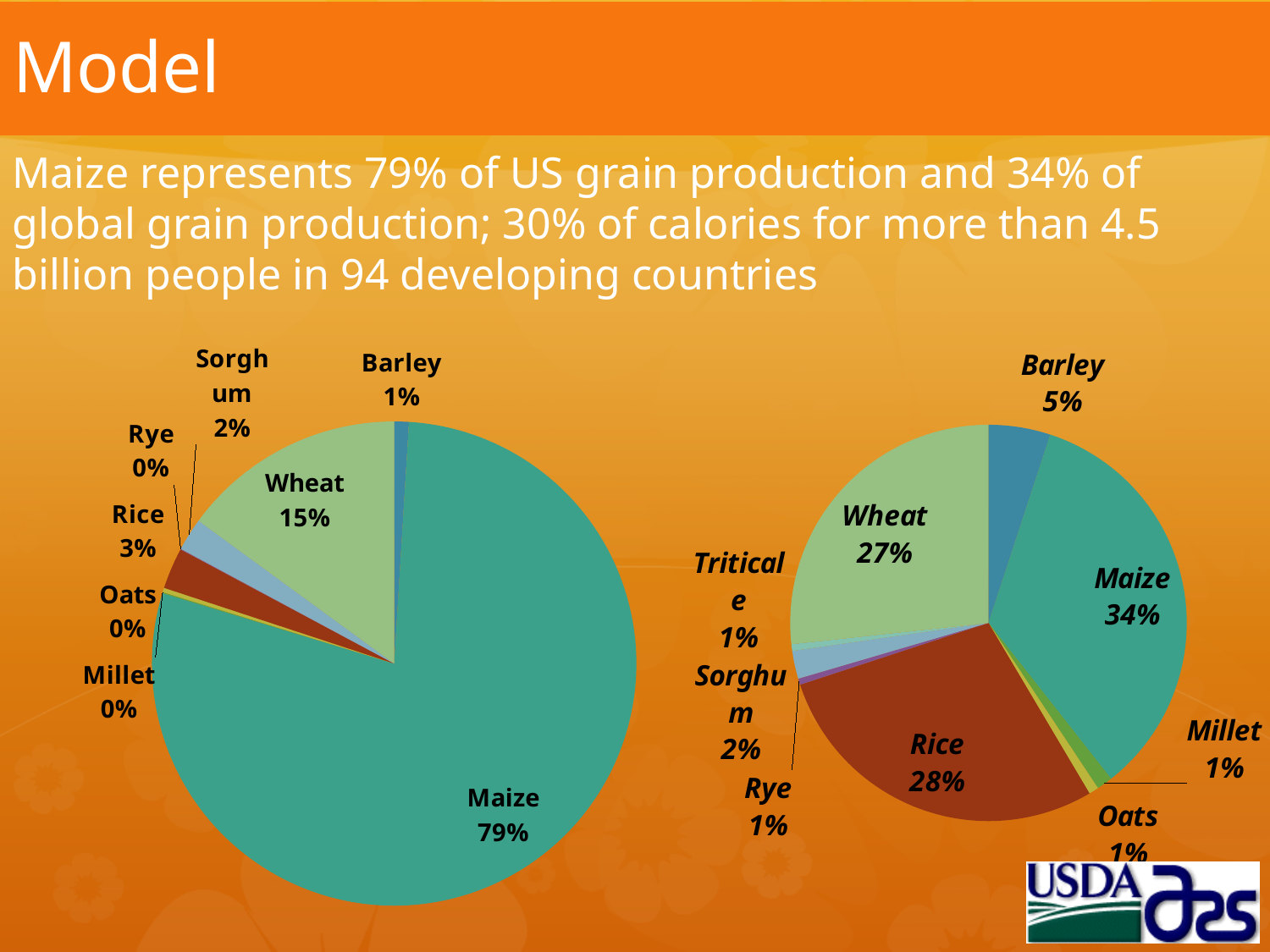
How many categories are labelled in the left pie chart? 8 In the right pie chart, which category has the largest share? Maize In the left pie chart, what share does Maize have? 79% In the left pie chart, what is the difference between the Maize share and the Wheat share? 64% In the right pie chart, what share does Rice have? 28% In the right pie chart, which is larger, the Rice share or the Wheat share? Rice What type of chart is the chart on the left of the slide? Pie chart In the right pie chart, what is the difference between the Maize share and the Wheat share? 7% In the right pie chart, what share does Barley have? 5% In the left pie chart, what share does Wheat have? 15% How many categories are labelled in the right pie chart? 9 In the left pie chart, which category has the largest share? Maize